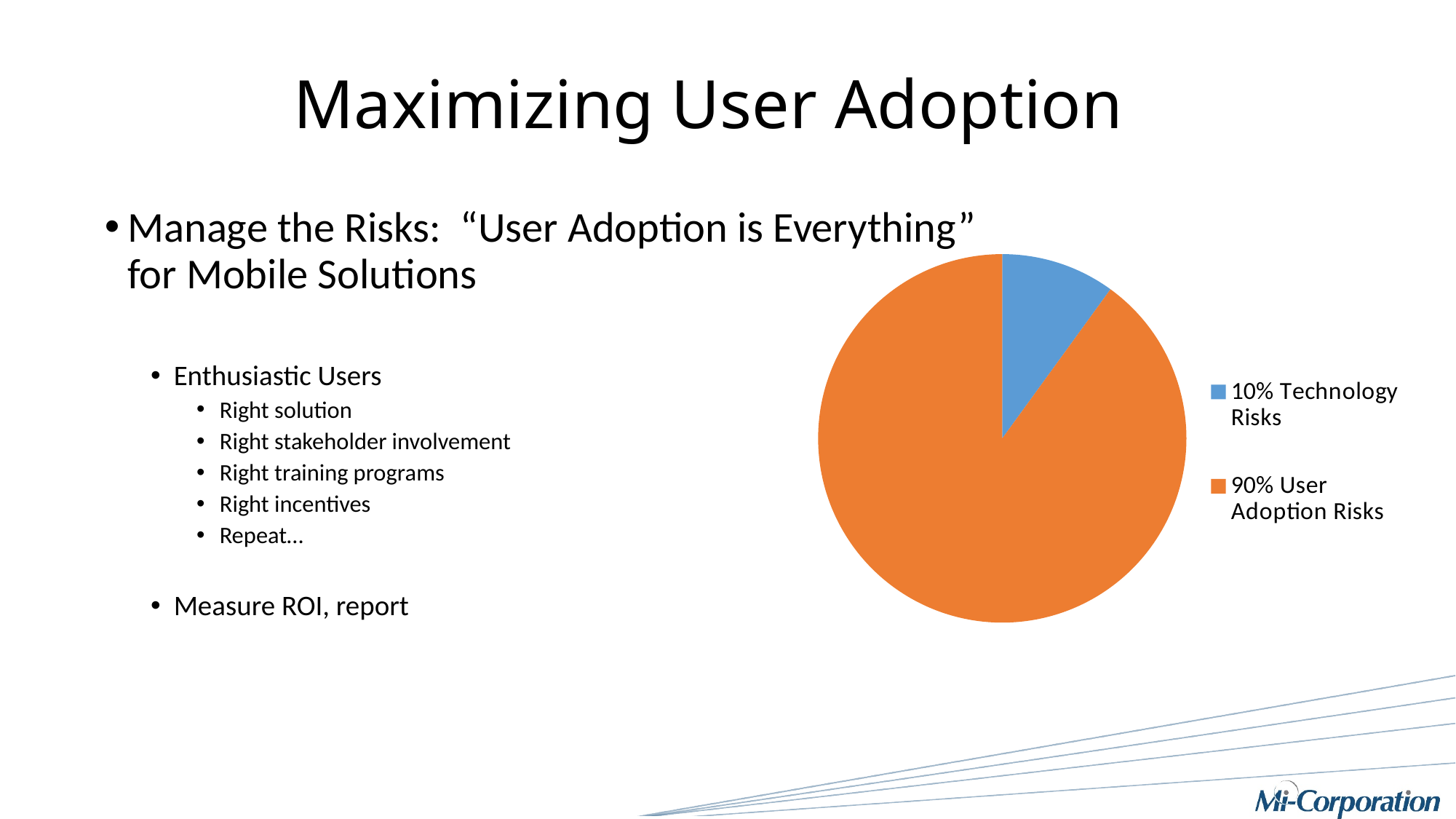
How many slices does the pie chart have? 2 What kind of chart is shown on the slide? pie chart What share of the pie is User Adoption Risks? 90% What colour is the User Adoption Risks slice in the pie chart? orange Which is larger in the pie chart, Technology Risks or User Adoption Risks? User Adoption Risks How many entries does the pie chart's legend list? 2 Which slice of the pie chart is the smallest? 10% Technology Risks What share of the pie is Technology Risks? 10% What is the difference in percentage points between the User Adoption Risks slice and the Technology Risks slice? 80 Which slice of the pie chart is the largest? 90% User Adoption Risks What colour is the Technology Risks slice in the pie chart? blue